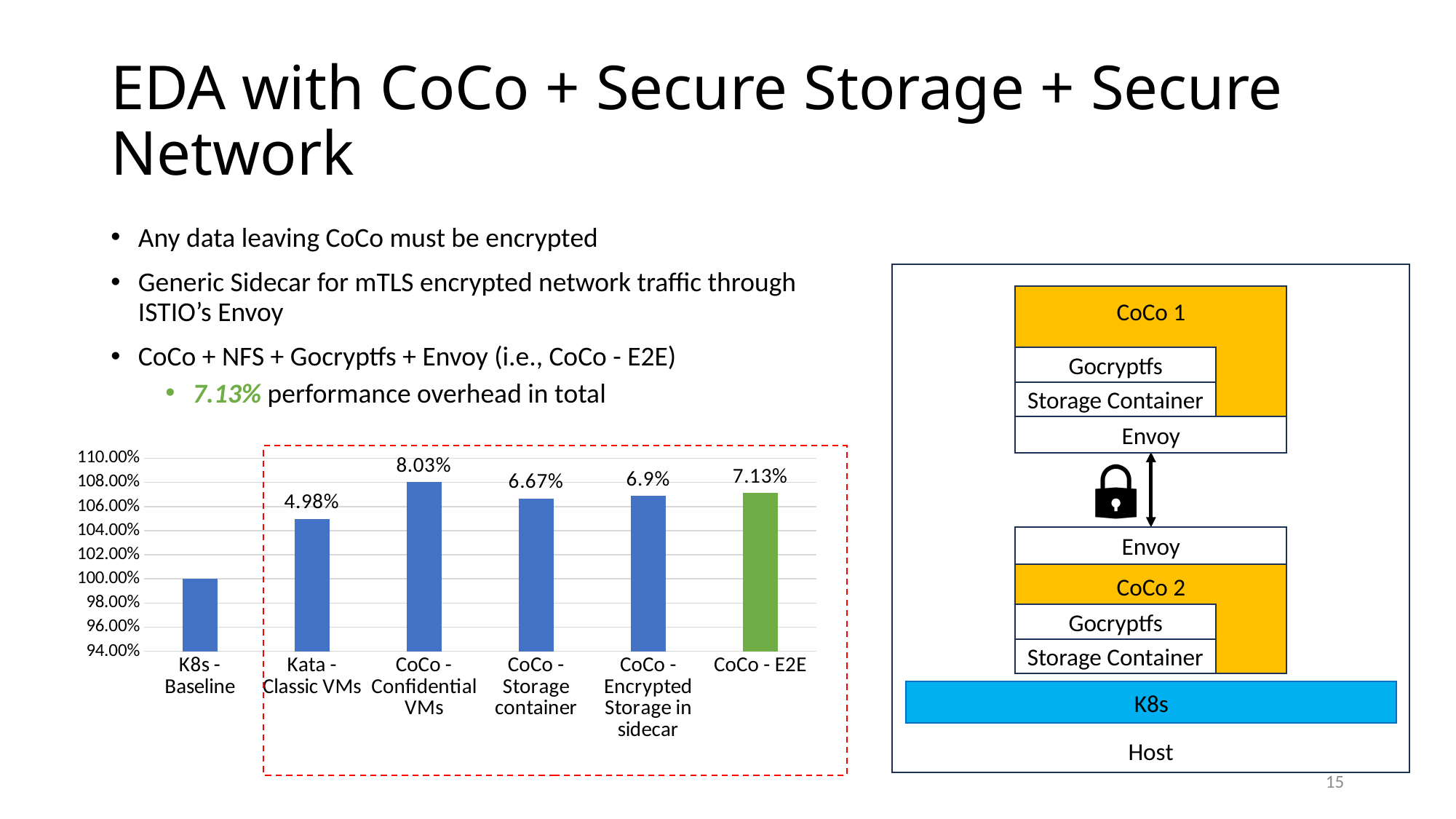
Which has the larger labeled value, CoCo - Storage container or CoCo - Encrypted Storage in sidecar? CoCo - Encrypted Storage in sidecar Is the bar for K8s - Baseline greater or less than 104.00% on the y axis? less What is the difference between the labeled values for CoCo - Confidential VMs and Kata - Classic VMs? 3.05% What is the data label shown above the bar for Kata - Classic VMs? 4.98% What is the data label shown above the bar for CoCo - Storage container? 6.67% What is the data label shown above the bar for CoCo - Encrypted Storage in sidecar? 6.9% What is the data label shown above the bar for CoCo - Confidential VMs? 8.03% How many categories are plotted on the chart? 6 Which category has the shortest bar on the chart? K8s - Baseline What is the data label shown above the bar for CoCo - E2E? 7.13% Which category has the highest labeled overhead value? CoCo - Confidential VMs What kind of chart is shown on the slide? bar chart